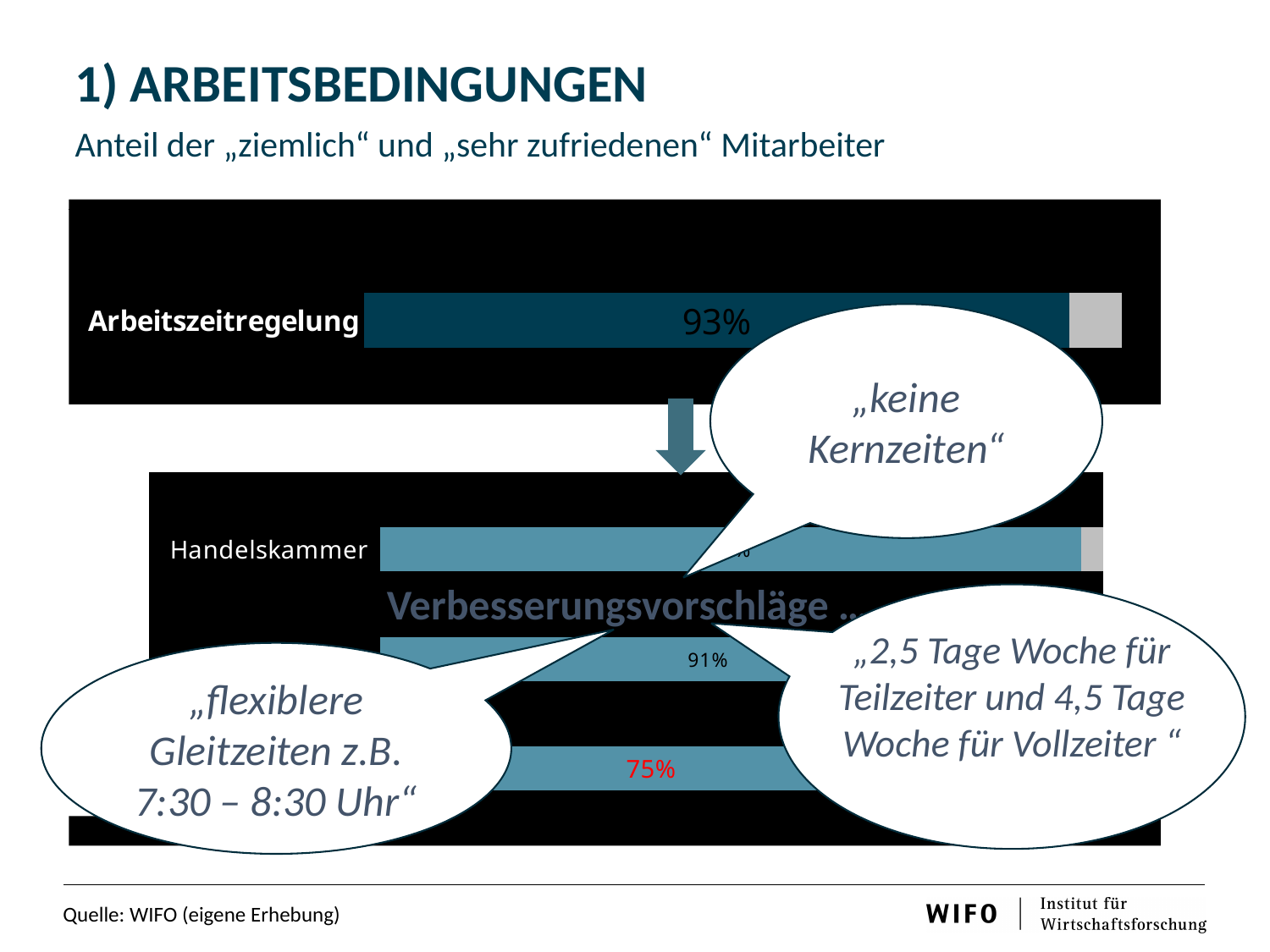
What kind of chart is used on this slide to show the share of satisfied employees? bar chart What is the difference between the 91% bar and the 75% bar in the lower chart? 16% In the lower chart, which printed value is larger: 91% or 75%? 91% What is the difference between the Arbeitszeitregelung value (93%) and the 75% bar in the lower chart? 18% Which category is labelled on the bar in the top chart? Arbeitszeitregelung In the lower chart, what is the label of the first (topmost) bar? Handelskammer What is the value shown for Arbeitszeitregelung in the top chart? 93%